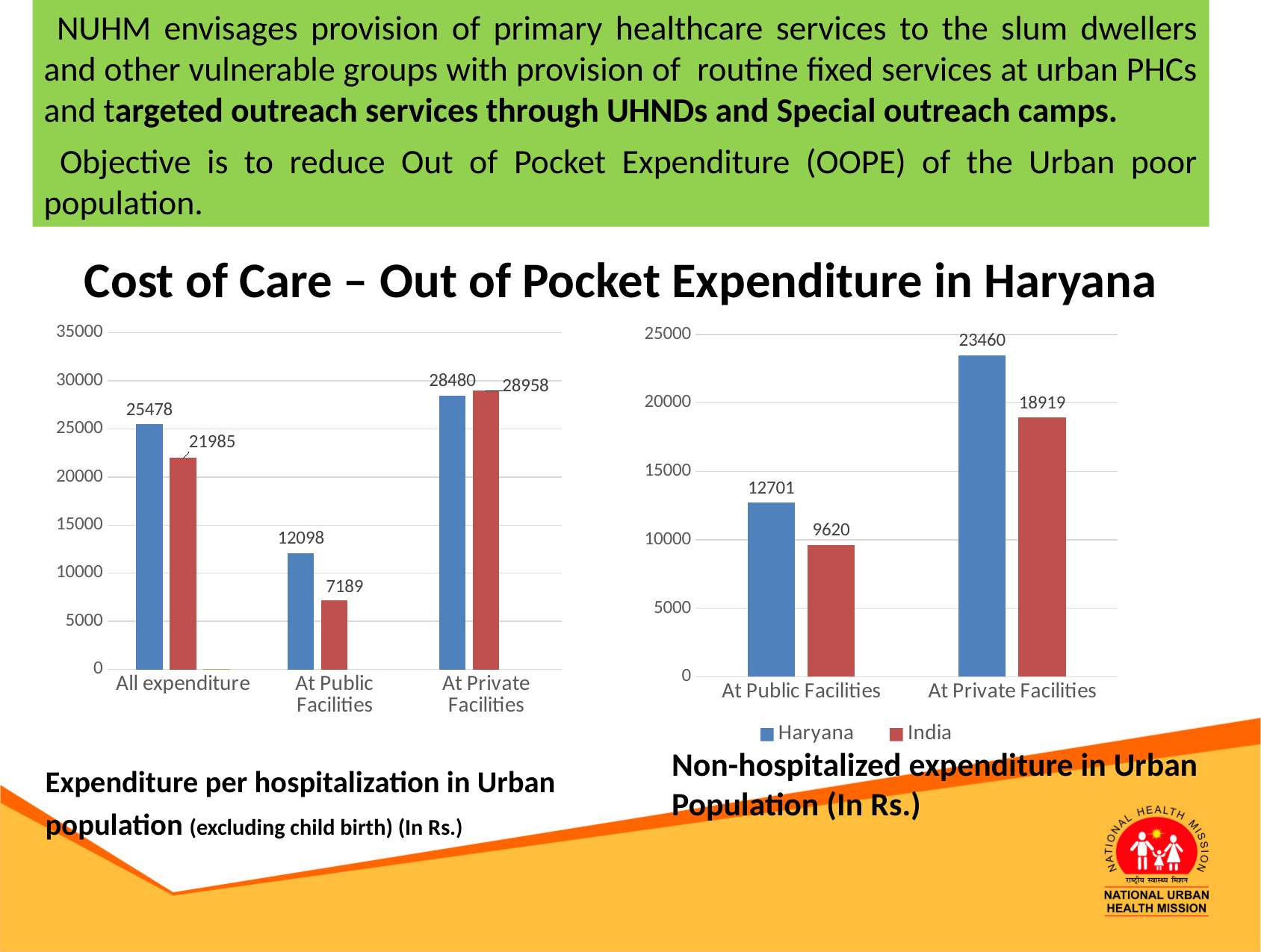
In the 'Expenditure per hospitalization in Urban population' chart, what is the value of the red bar for All expenditure? 21985 In the 'Non-hospitalized expenditure in Urban Population' chart, which bar is the highest? Haryana at Private Facilities In the 'Non-hospitalized expenditure in Urban Population' chart, what is the difference between Haryana and India at Private Facilities? 4541 In the 'Non-hospitalized expenditure in Urban Population' chart, what is the value for India at Private Facilities? 18919 In the 'Expenditure per hospitalization in Urban population' chart, what is the difference between the blue and red bars for At Public Facilities? 4909 In the 'Non-hospitalized expenditure in Urban Population' chart, what is the value for Haryana at Public Facilities? 12701 What type of chart is the 'Non-hospitalized expenditure in Urban Population' chart? Bar chart How many series does the legend of the 'Non-hospitalized expenditure in Urban Population' chart list? 2 In the 'Non-hospitalized expenditure in Urban Population' chart, which is larger at Public Facilities, Haryana or India? Haryana How many categories are shown on the x axis of the 'Expenditure per hospitalization in Urban population' chart? 3 In the 'Expenditure per hospitalization in Urban population' chart, what is the value of the blue bar for At Public Facilities? 12098